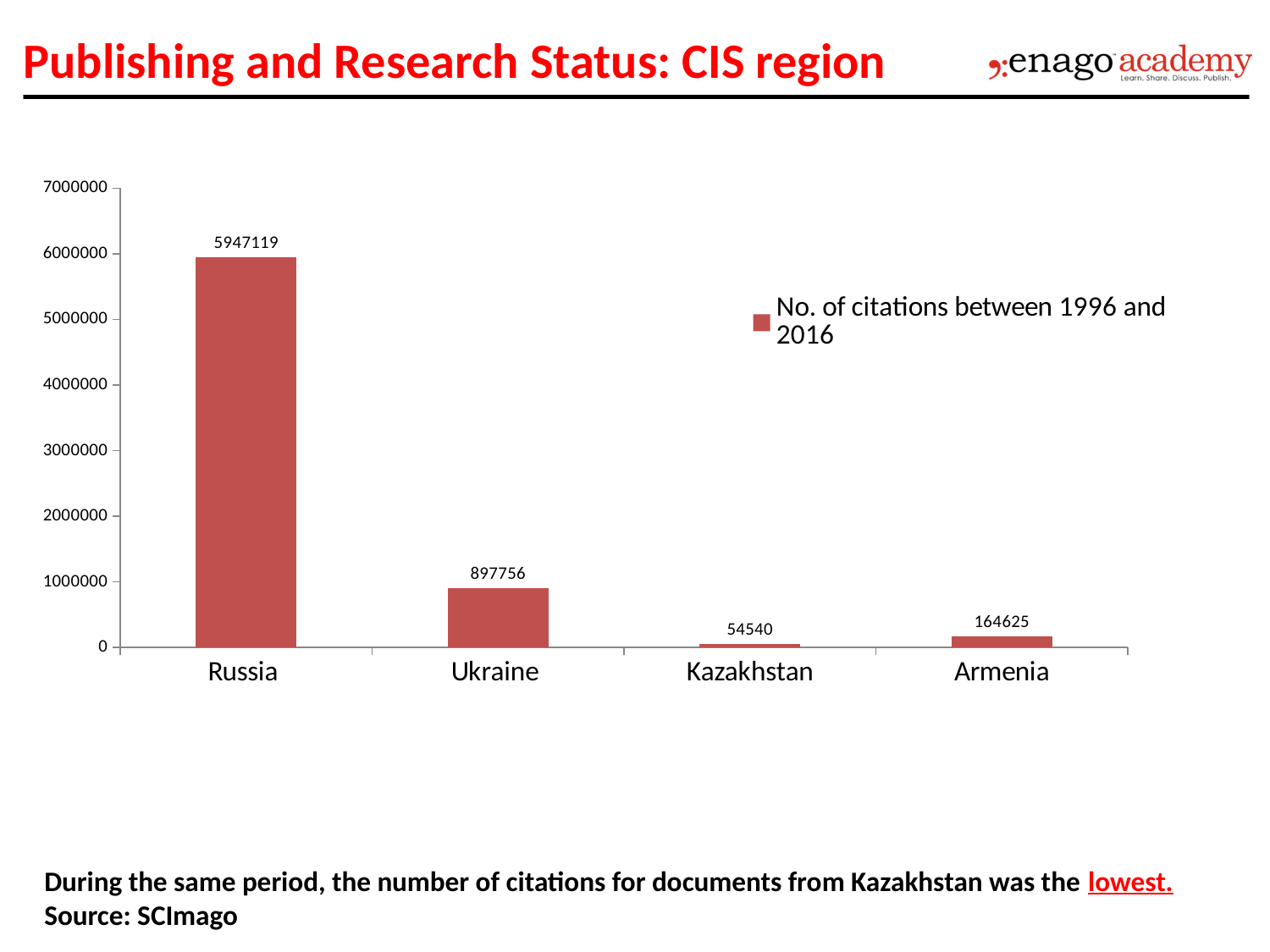
What is the difference in citations between Armenia and Kazakhstan? 110085 What is the legend entry for the series shown on the chart? No. of citations between 1996 and 2016 How many countries are shown on the chart? 4 What kind of chart is shown on the slide? Bar chart What is the difference in citations between Russia and Ukraine? 5049363 Which country has the highest number of citations? Russia What is the number of citations between 1996 and 2016 for Russia? 5947119 What is the number of citations between 1996 and 2016 for Armenia? 164625 Which country has the lowest number of citations? Kazakhstan What is the number of citations between 1996 and 2016 for Ukraine? 897756 What is the number of citations between 1996 and 2016 for Kazakhstan? 54540 Which has more citations, Ukraine or Armenia? Ukraine